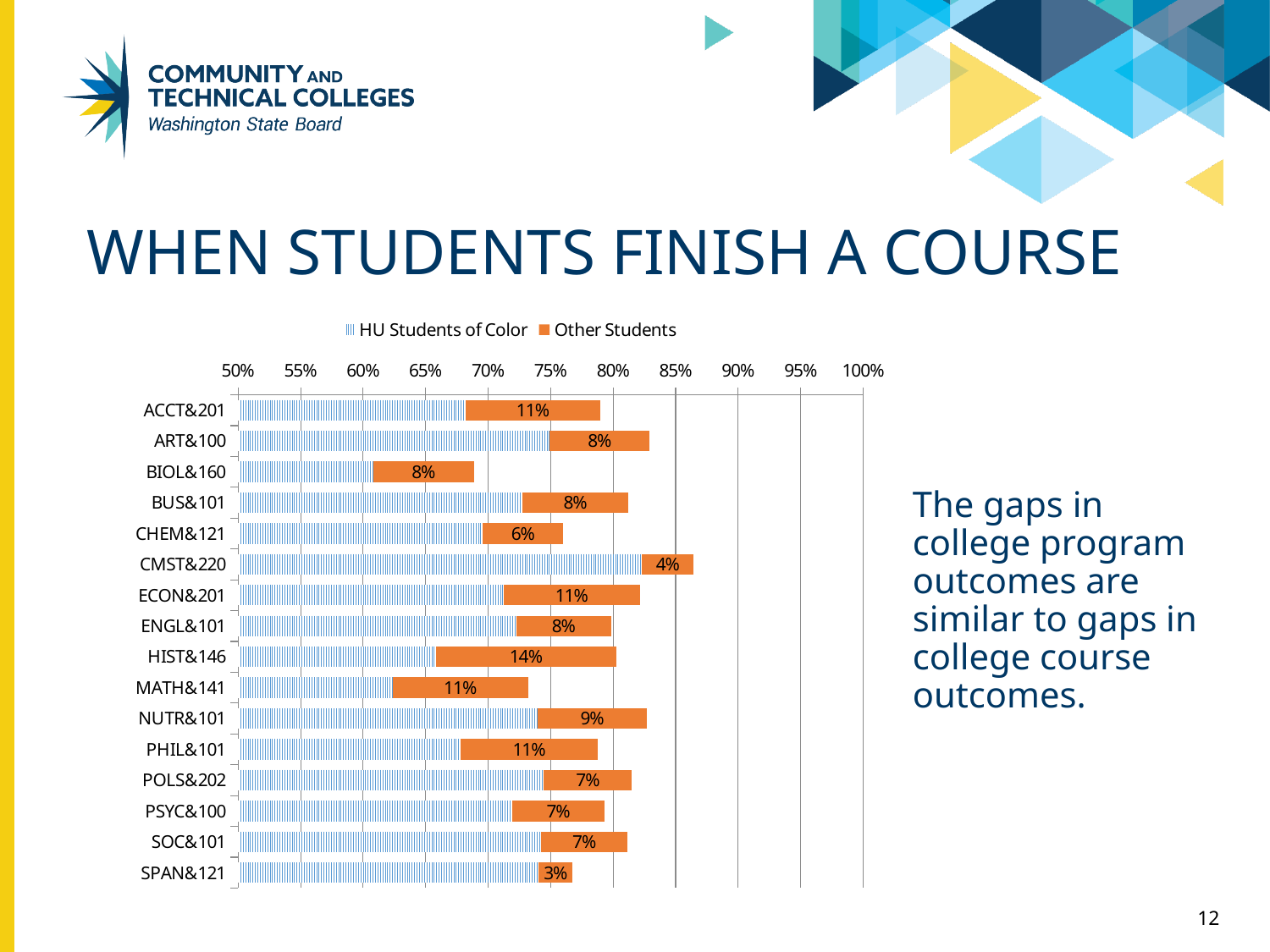
Which course has the smallest labeled gap on its orange segment? SPAN&121 Is the HU Students of Color value for BIOL&160 greater or less than 65%? less What are the two series named in the chart legend? HU Students of Color and Other Students What is the difference between the labeled gap for HIST&146 and the labeled gap for SPAN&121? 11% Which has a larger labeled gap, ACCT&201 or ART&100? ACCT&201 How many courses are plotted on the chart? 16 How many series does the chart legend list? 2 Which course has the largest labeled gap on its orange segment? HIST&146 What is the labeled gap value shown on the orange segment for CMST&220? 4% What is the labeled gap value shown on the orange segment for SPAN&121? 3% What kind of chart is shown on the slide? bar chart What is the labeled gap value shown on the orange segment for HIST&146? 14%